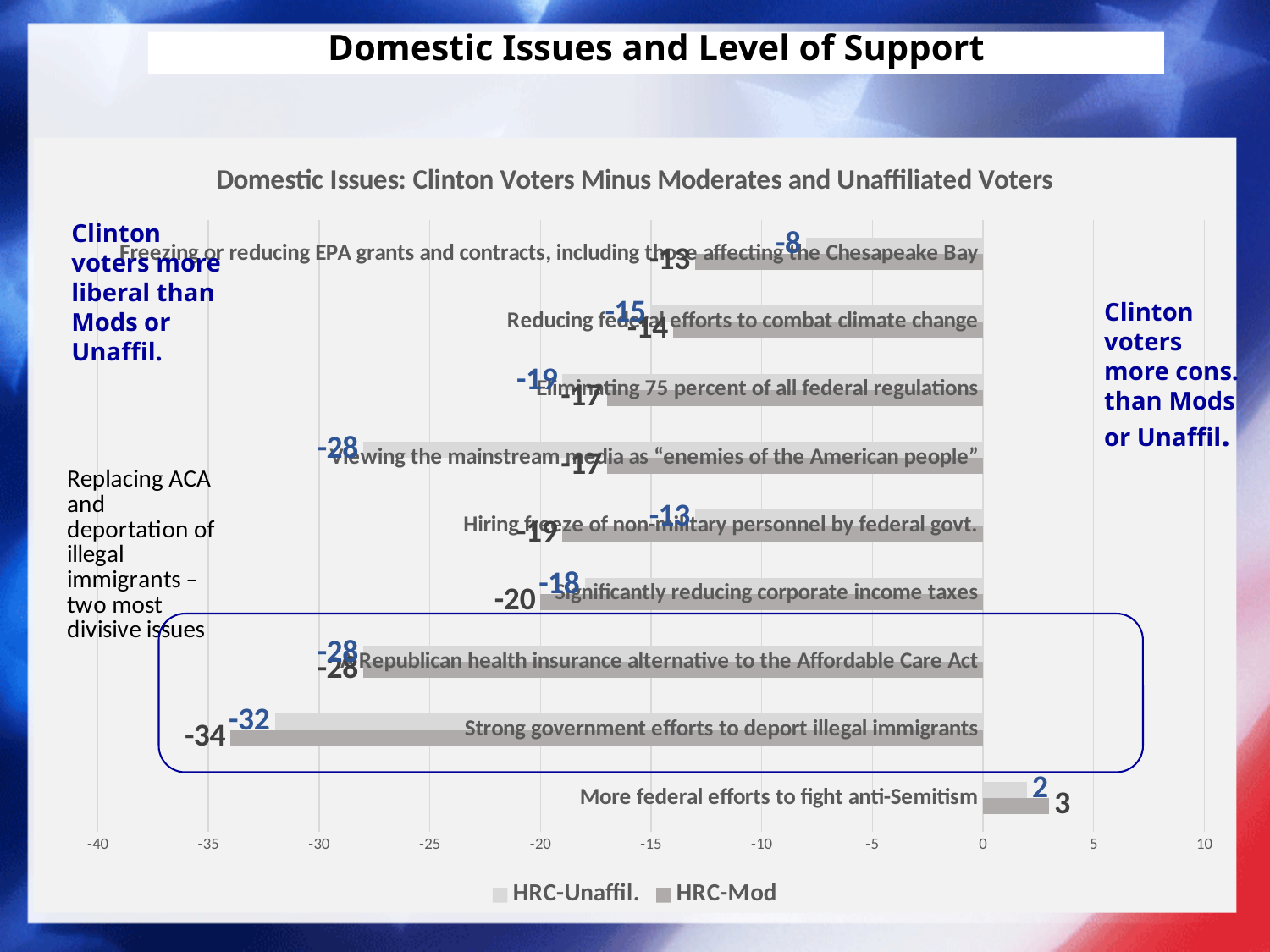
What is the HRC-Unaffil. value for 'Freezing or reducing EPA grants and contracts, including those affecting the Chesapeake Bay'? -8 What are the two legend entries of the chart? HRC-Unaffil. and HRC-Mod What is the HRC-Mod value for 'Strong government efforts to deport illegal immigrants'? -34 Is the HRC-Unaffil. value for 'Republican health insurance alternative to the Affordable Care Act' greater or less than -25? less What kind of chart is shown on the slide? bar chart How many domestic issues (categories) are plotted in the chart? 9 Which issue has the highest HRC-Unaffil. value? More federal efforts to fight anti-Semitism Which issue has the lowest HRC-Mod value? Strong government efforts to deport illegal immigrants How many series does the legend list? 2 For 'Viewing the mainstream media as "enemies of the American people"', which series has the lower value, HRC-Unaffil. or HRC-Mod? HRC-Unaffil. What is the HRC-Mod value for 'More federal efforts to fight anti-Semitism'? 3 What is the difference between the HRC-Unaffil. value (-32) and the HRC-Mod value (-34) for 'Strong government efforts to deport illegal immigrants'? 2